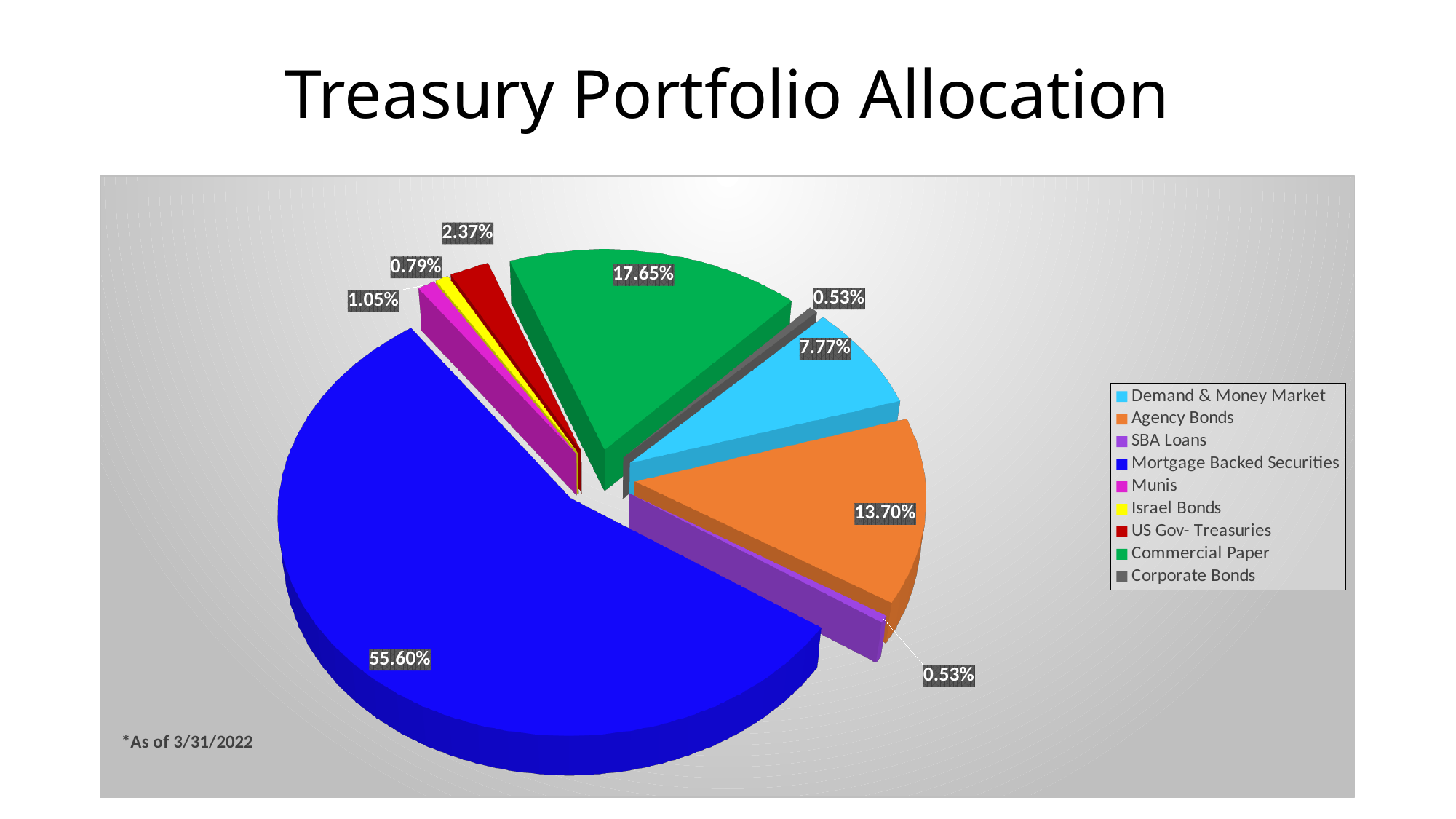
What is the difference in percentage points between Commercial Paper and Agency Bonds? 3.95 How many categories does the legend list? 9 What type of chart is shown on the slide? Pie chart Which is larger, the Munis slice or the Israel Bonds slice? Munis Which category has the largest share of the pie? Mortgage Backed Securities What is the value labelled on the Agency Bonds slice? 13.70% What colour is the Commercial Paper slice? Green What percentage does the Commercial Paper slice show? 17.65% What percentage is shown for Demand & Money Market? 7.77% What percentage is shown for US Gov- Treasuries? 2.37% What share of the Treasury Portfolio Allocation pie is Mortgage Backed Securities? 55.60% What is the combined share of Demand & Money Market and Agency Bonds? 21.47%